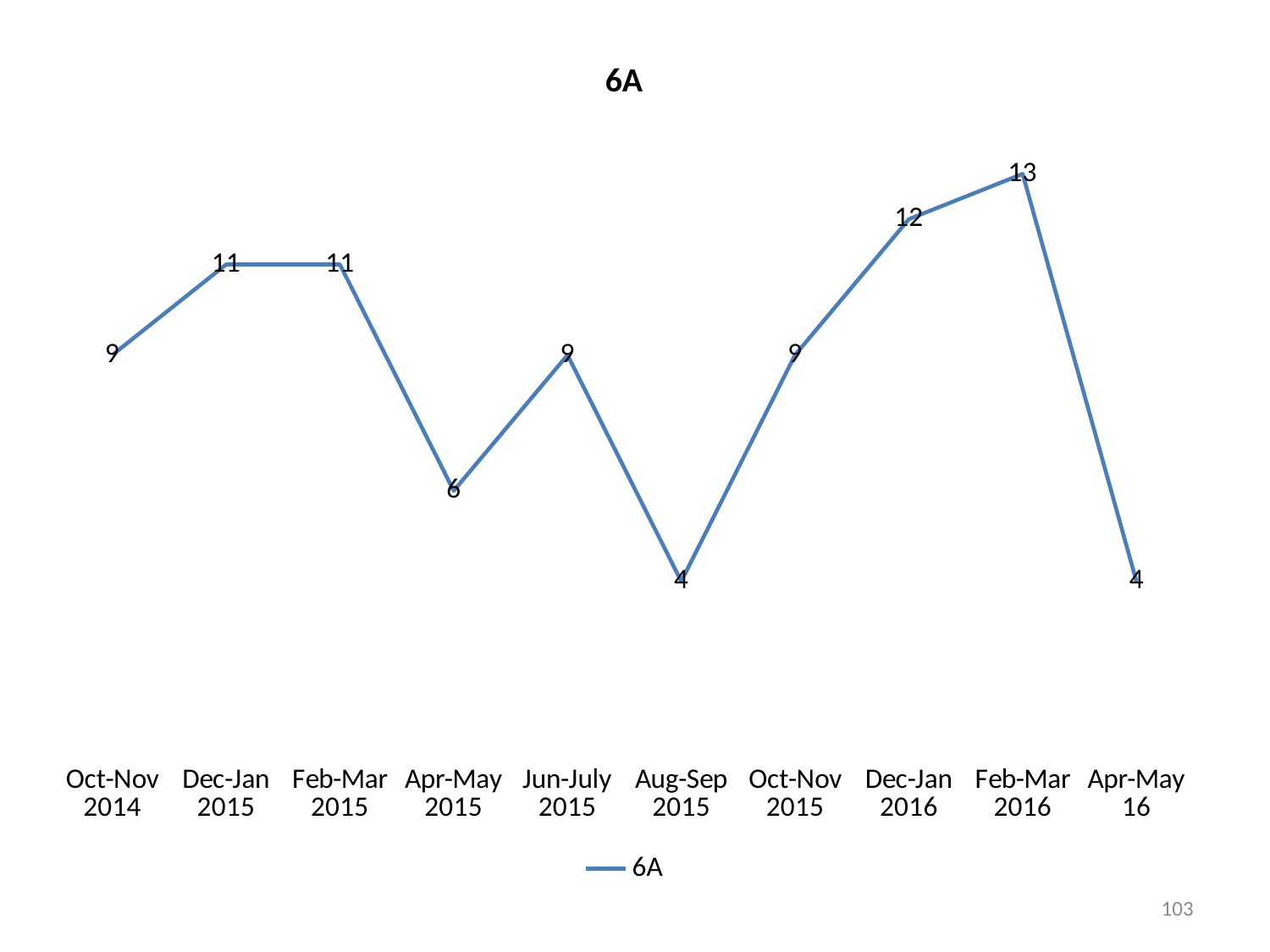
What is the lowest value shown on the chart? 4 Which is larger, the value for Dec-Jan 2015 or the value for Jun-July 2015? Dec-Jan 2015 What is the value for Dec-Jan 2016? 12 How many periods are plotted on the x axis? 10 Which period has the highest value? Feb-Mar 2016 What is the value for Apr-May 2015? 6 What is the value for Feb-Mar 2016? 13 What is the difference between the values for Feb-Mar 2016 and Apr-May 16? 9 Do the values rise or fall from Oct-Nov 2015 to Feb-Mar 2016? rise What is the title of the chart? 6A What kind of chart is shown? line chart How many series does the legend list? 1